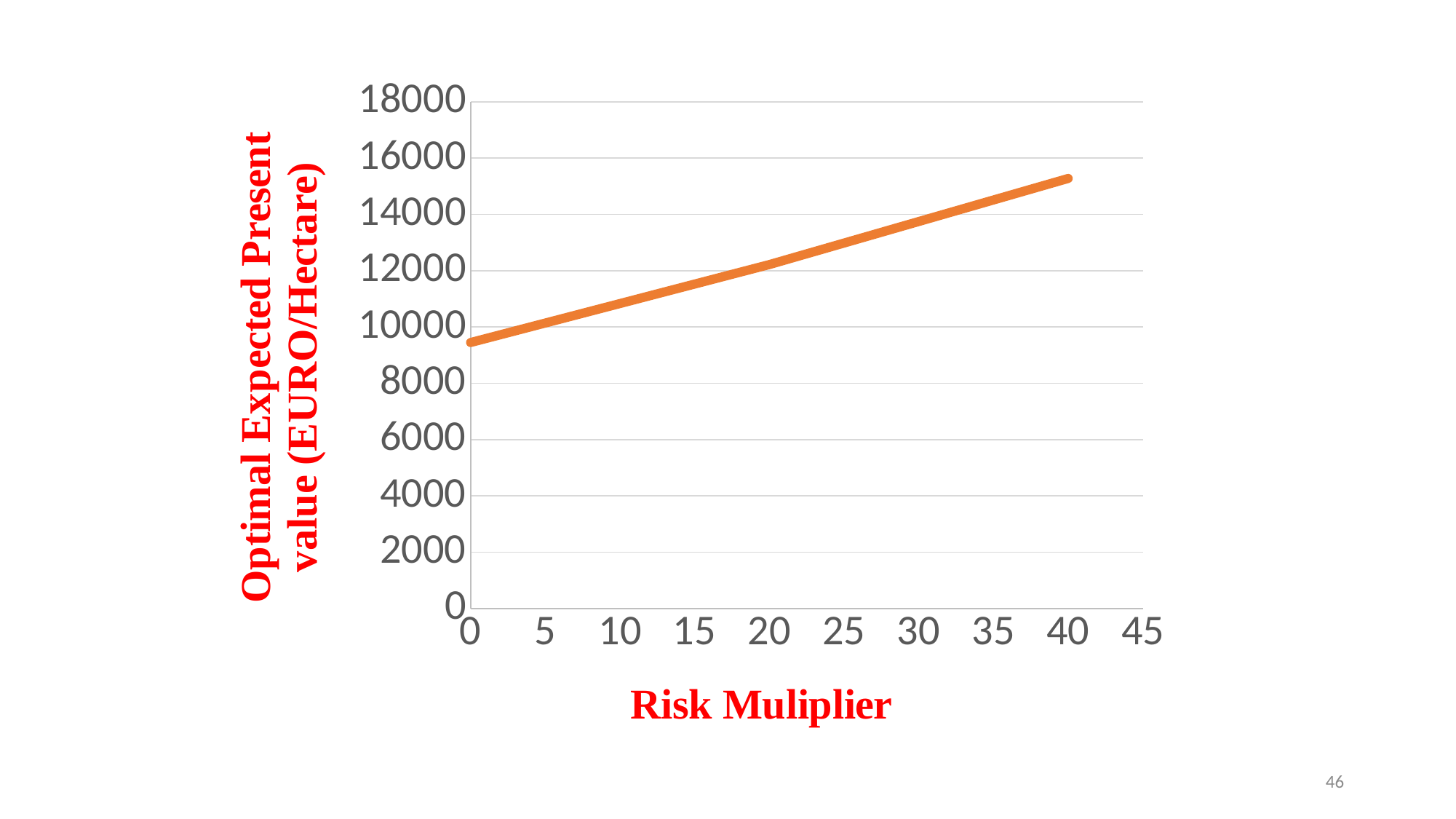
Does the Optimal Expected Present value rise or fall as the Risk Multiplier increases? rise What is the label of the x axis? Risk Muliplier Is the Optimal Expected Present value at a Risk Multiplier of 40 greater or less than 16000? less Which has the larger Optimal Expected Present value: a Risk Multiplier of 0 or a Risk Multiplier of 40? 40 Is the Optimal Expected Present value at a Risk Multiplier of 0 greater or less than 8000? greater Is the Optimal Expected Present value at a Risk Multiplier of 20 greater or less than 10000? greater What is the label of the y axis? Optimal Expected Present value (EURO/Hectare) What kind of chart is shown on the slide? line chart What is the highest value shown on the y axis? 18000